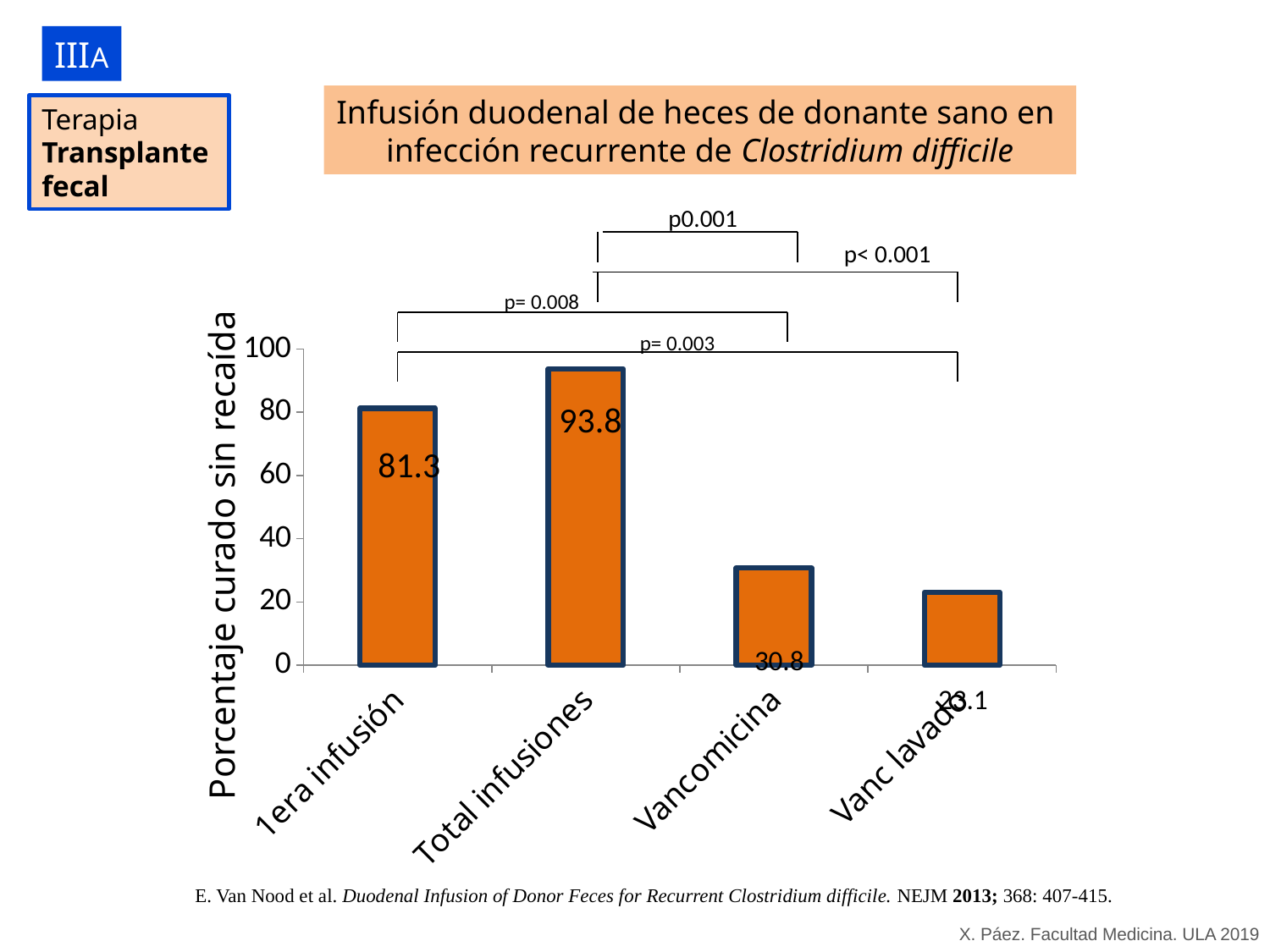
What is the difference between the values for 1era infusión and Vancomicina? 50.5 What kind of chart is shown on the slide? bar chart Which category has the lowest value? Vanc lavado Is the value for Vanc lavado greater or less than 40? less What is the value for 1era infusión? 81.3 Which is larger, the value for Vancomicina or the value for Vanc lavado? Vancomicina How many categories are shown on the x axis? 4 What is the difference between the values for Total infusiones and 1era infusión? 12.5 What is the title of the vertical axis? Porcentaje curado sin recaída Which category has the highest value? Total infusiones What is the value for Vancomicina? 30.8 What is the value for Total infusiones? 93.8